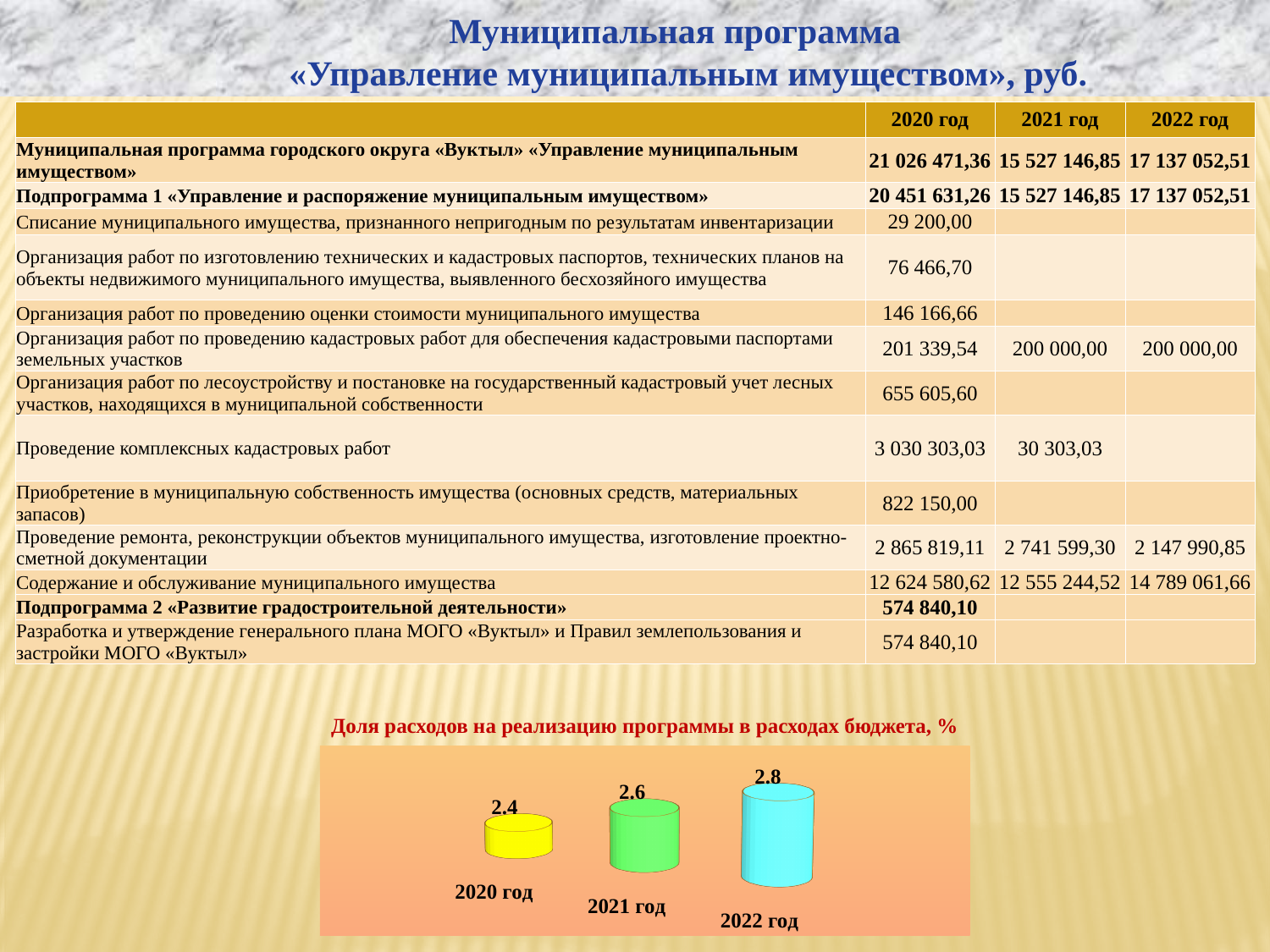
Which year has the highest value in the chart 'Доля расходов на реализацию программы в расходах бюджета, %'? 2022 год What is the value shown for 2022 год in the chart 'Доля расходов на реализацию программы в расходах бюджета, %'? 2.8 What colour is the bar for 2020 год in the chart 'Доля расходов на реализацию программы в расходах бюджета, %'? yellow Do the values in the chart 'Доля расходов на реализацию программы в расходах бюджета, %' rise or fall from 2020 год to 2022 год? rise In the chart 'Доля расходов на реализацию программы в расходах бюджета, %', which is larger: the value for 2021 год or the value for 2022 год? 2022 год How many years (categories) are shown in the chart 'Доля расходов на реализацию программы в расходах бюджета, %'? 3 What is the value shown for 2021 год in the chart 'Доля расходов на реализацию программы в расходах бюджета, %'? 2.6 What kind of chart is 'Доля расходов на реализацию программы в расходах бюджета, %'? bar chart Which year has the lowest value in the chart 'Доля расходов на реализацию программы в расходах бюджета, %'? 2020 год In the chart 'Доля расходов на реализацию программы в расходах бюджета, %', what is the difference between the values for 2022 год and 2020 год? 0.4 In the chart 'Доля расходов на реализацию программы в расходах бюджета, %', what is the difference between the values for 2021 год and 2020 год? 0.2 What is the value shown for 2020 год in the chart 'Доля расходов на реализацию программы в расходах бюджета, %'? 2.4